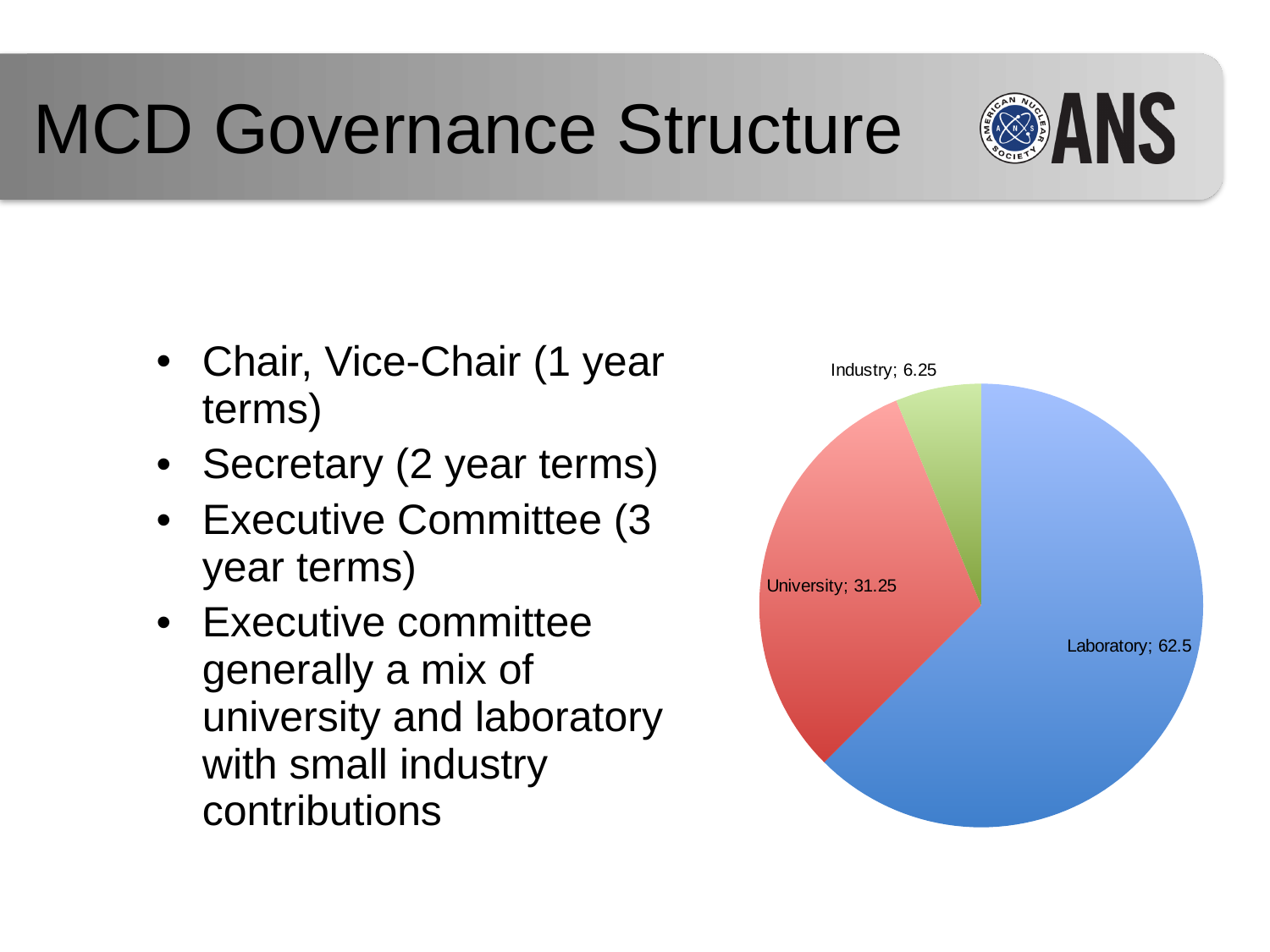
Which category has the largest slice? Laboratory How many slices does the pie chart have? 3 Which category has the smallest slice? Industry What kind of chart is shown on the slide? pie chart What is the value for Laboratory? 62.5 What colour is the Laboratory slice? blue What is the difference between the Laboratory and University values? 31.25 What is the total of all three slice values? 100 What is the difference between the University and Industry values? 25 What is the value for Industry? 6.25 What is the value for University? 31.25 Which is larger, University or Industry? University